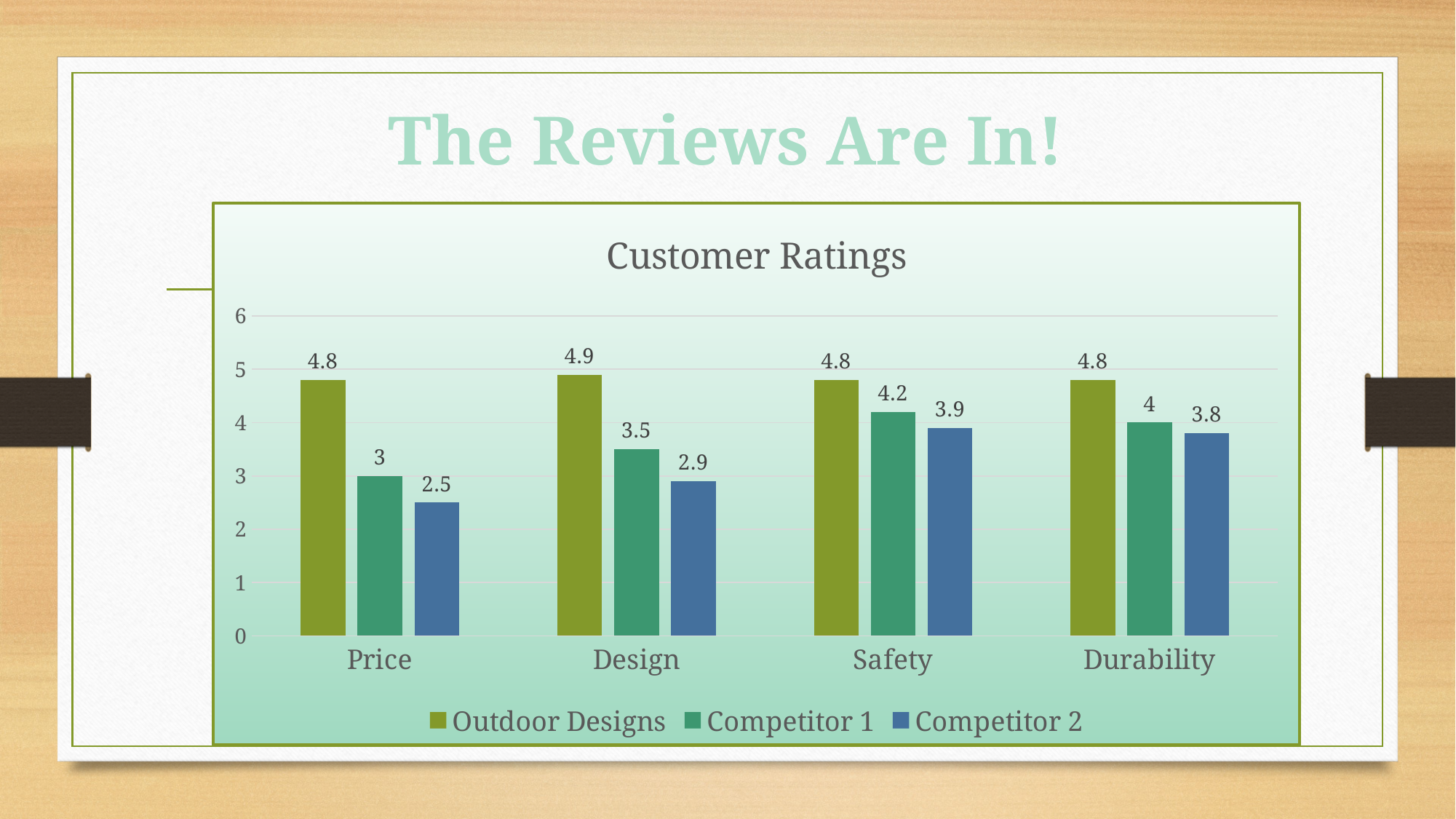
What kind of chart is shown on the slide? Bar chart What is the difference between the Outdoor Designs and Competitor 2 ratings for Price? 2.3 What is the title of the chart? Customer Ratings How many categories are shown on the x axis? 4 What is the Competitor 1 rating for Durability? 4 Which is higher for Design: the Competitor 1 rating or the Competitor 2 rating? Competitor 1 In which category does Outdoor Designs have its highest rating? Design What is the difference between the Competitor 1 and Competitor 2 ratings for Safety? 0.3 In which category does Competitor 2 have its lowest rating? Price How many series does the legend list? 3 What is the Competitor 2 rating for Design? 2.9 What is the Outdoor Designs rating for Price? 4.8